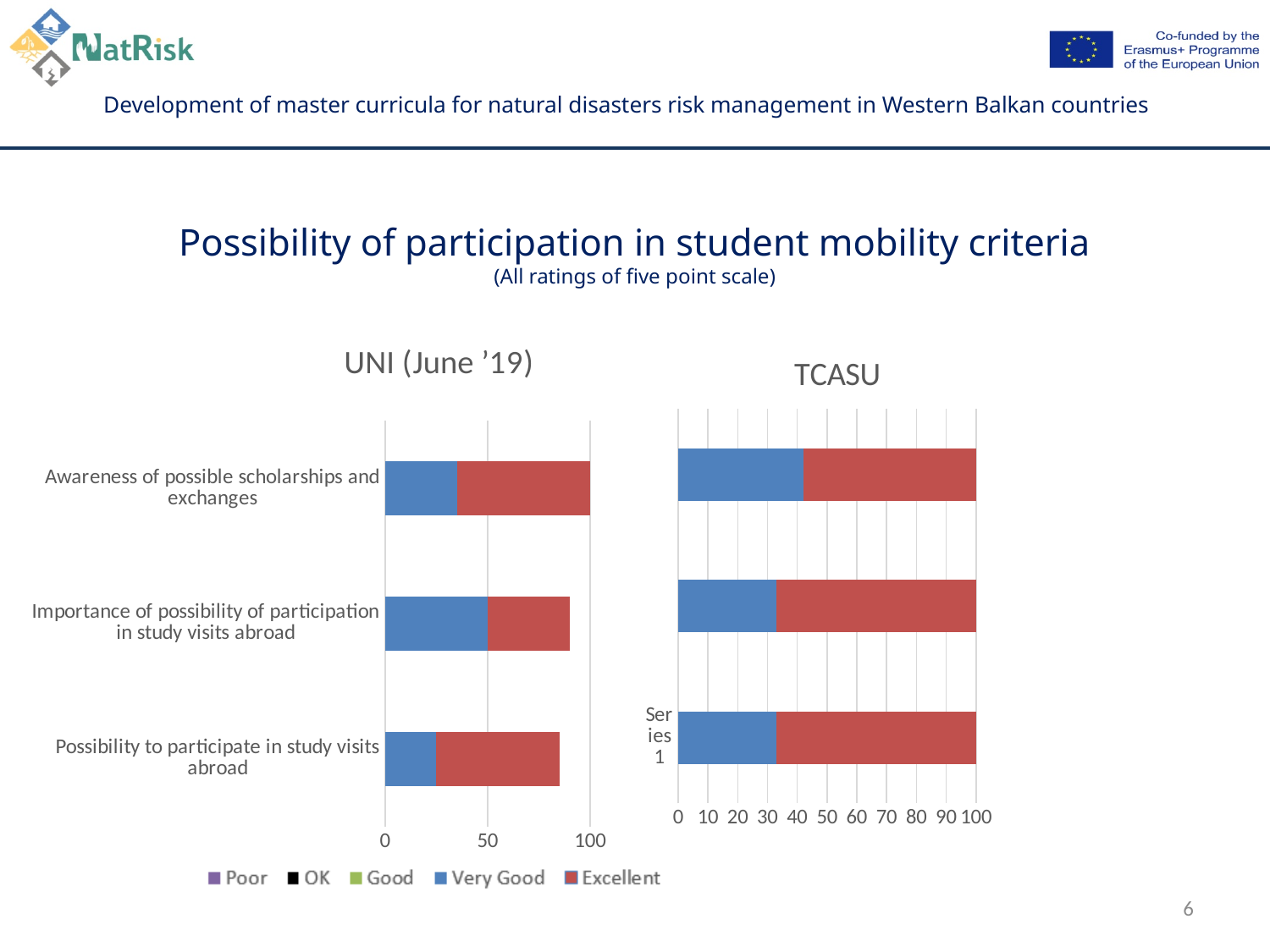
What kind of chart is the UNI (June '19) chart? bar chart In the UNI (June '19) chart, which category has the longest total bar? Awareness of possible scholarships and exchanges In the UNI (June '19) chart, is the Very Good segment for Awareness of possible scholarships and exchanges greater or less than 50? less In the TCASU chart, is the Very Good segment of the top bar greater or less than 50? less In the UNI (June '19) chart, is the total bar for Possibility to participate in study visits abroad greater or less than 100? less How many bars are shown in the TCASU chart? 3 How many series does the legend below the UNI (June '19) chart list? 5 In the UNI (June '19) chart, what is the total value of the bar for Awareness of possible scholarships and exchanges? 100 Which legend entry is shown in red in the UNI (June '19) chart? Excellent How many categories are shown in the UNI (June '19) chart? 3 In the UNI (June '19) chart, which total bar is longer: Awareness of possible scholarships and exchanges or Possibility to participate in study visits abroad? Awareness of possible scholarships and exchanges